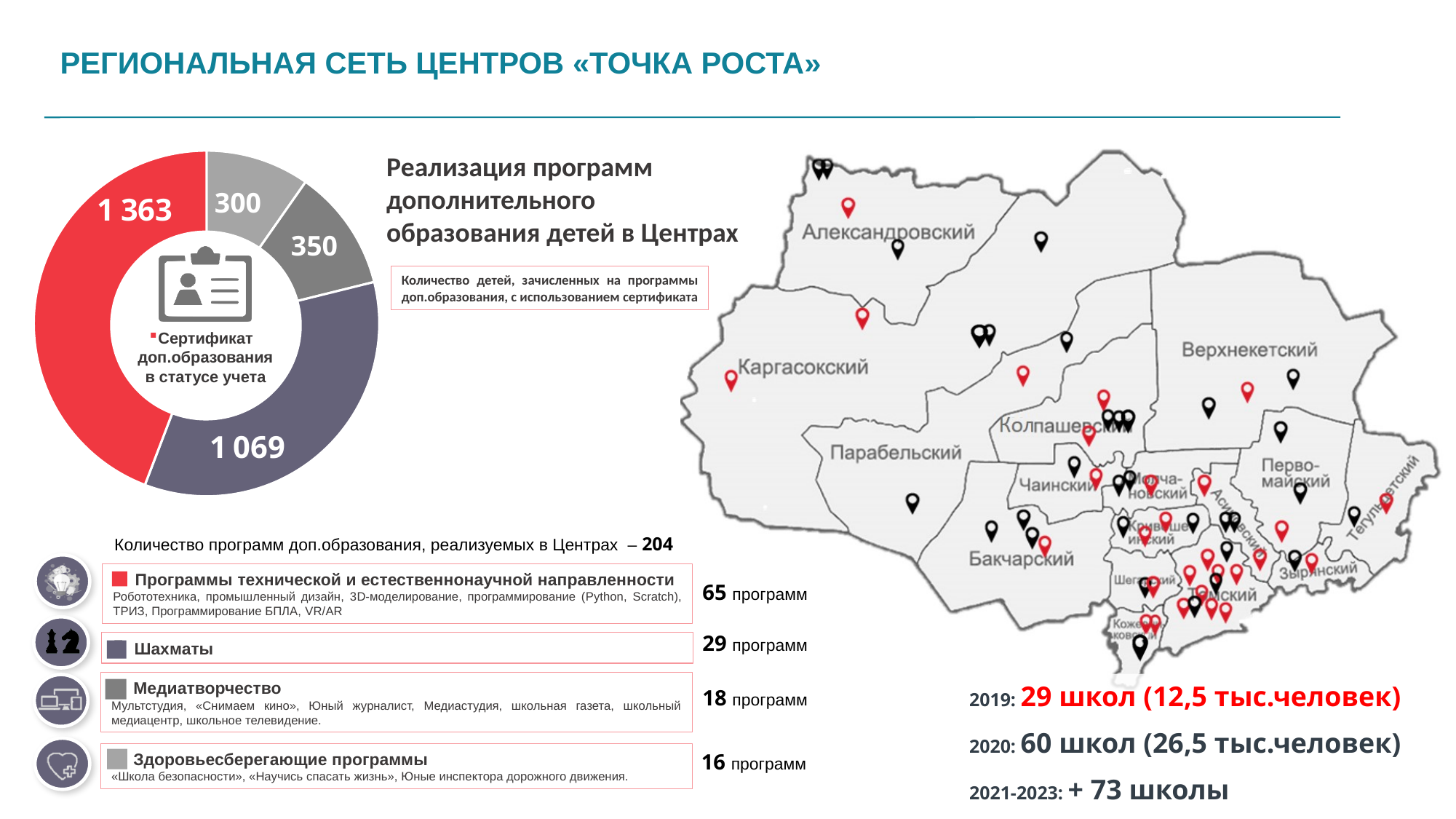
What is the value of the light gray segment of the donut chart? 300 How many segments does the donut chart have? 4 What is the total of all four values shown in the donut chart? 3 082 What is the text in the centre of the donut chart? Сертификат доп.образования в статусе учета What is the value of the dark purple segment of the donut chart? 1 069 What is the difference between the red segment (1 363) and the dark purple segment (1 069) in the donut chart? 294 Which segment of the donut chart has the smallest value? The light gray segment (300) What is the value of the red segment of the donut chart? 1 363 Which segment of the donut chart has the largest value? The red segment (1 363) What kind of chart is shown on the left of the slide? Donut (pie) chart What is the value of the dark gray segment of the donut chart? 350 Which is larger in the donut chart: the dark gray segment or the light gray segment? The dark gray segment (350)